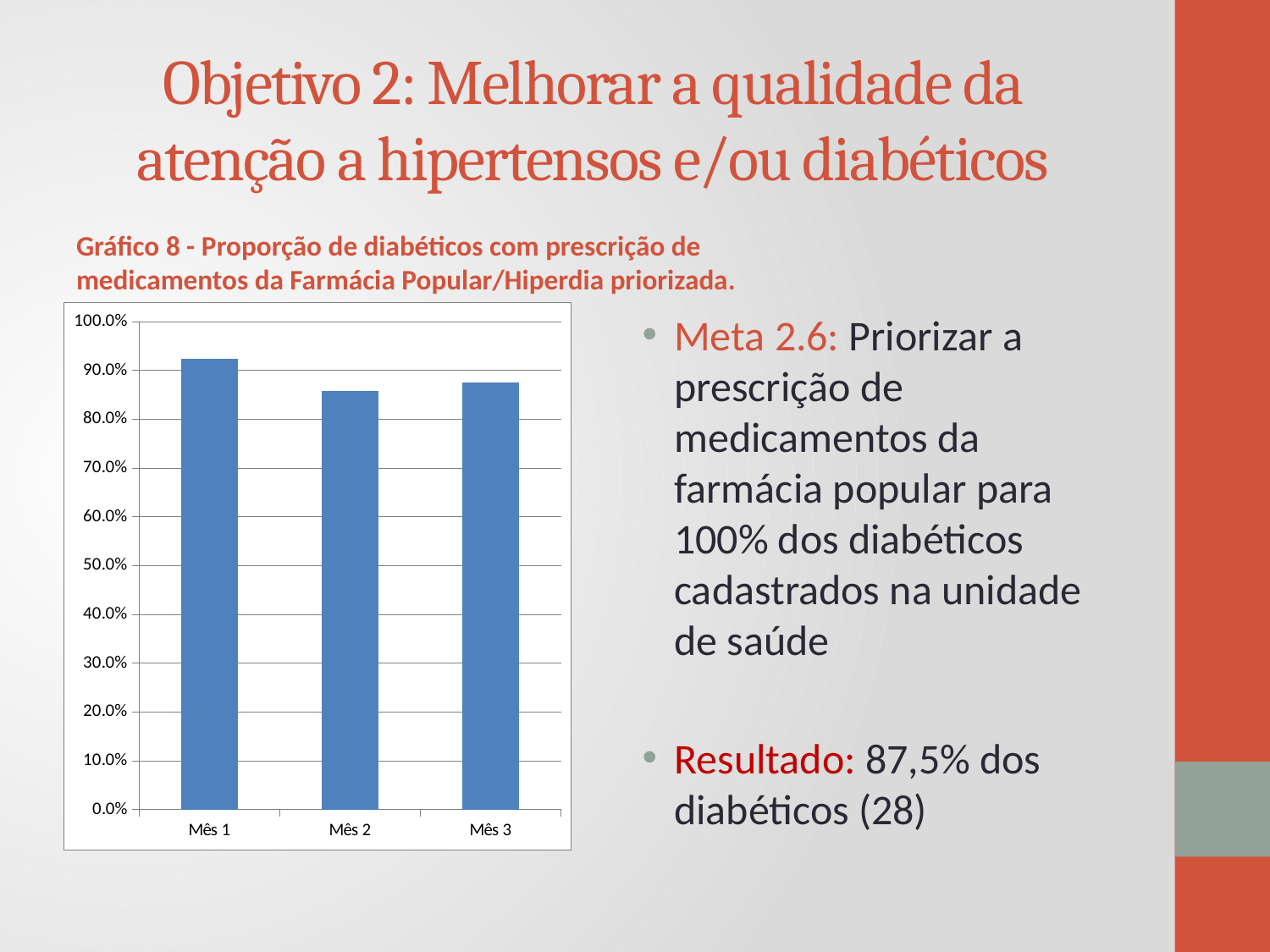
Is the value for Mês 2 greater or less than 90.0%? less Which is larger, the value for Mês 1 or the value for Mês 2? Mês 1 How many categories (months) are plotted on the chart? 3 Is the value for Mês 3 greater or less than 80.0%? greater Is the value for Mês 1 greater or less than 90.0%? greater Which month has the highest bar on the chart? Mês 1 What is the highest value shown on the chart's vertical axis? 100.0% Does the value rise or fall from Mês 1 to Mês 2? Falls What is the title of the chart (Gráfico 8)? Proporção de diabéticos com prescrição de medicamentos da Farmácia Popular/Hiperdia priorizada. What kind of chart is shown on the slide? Bar chart